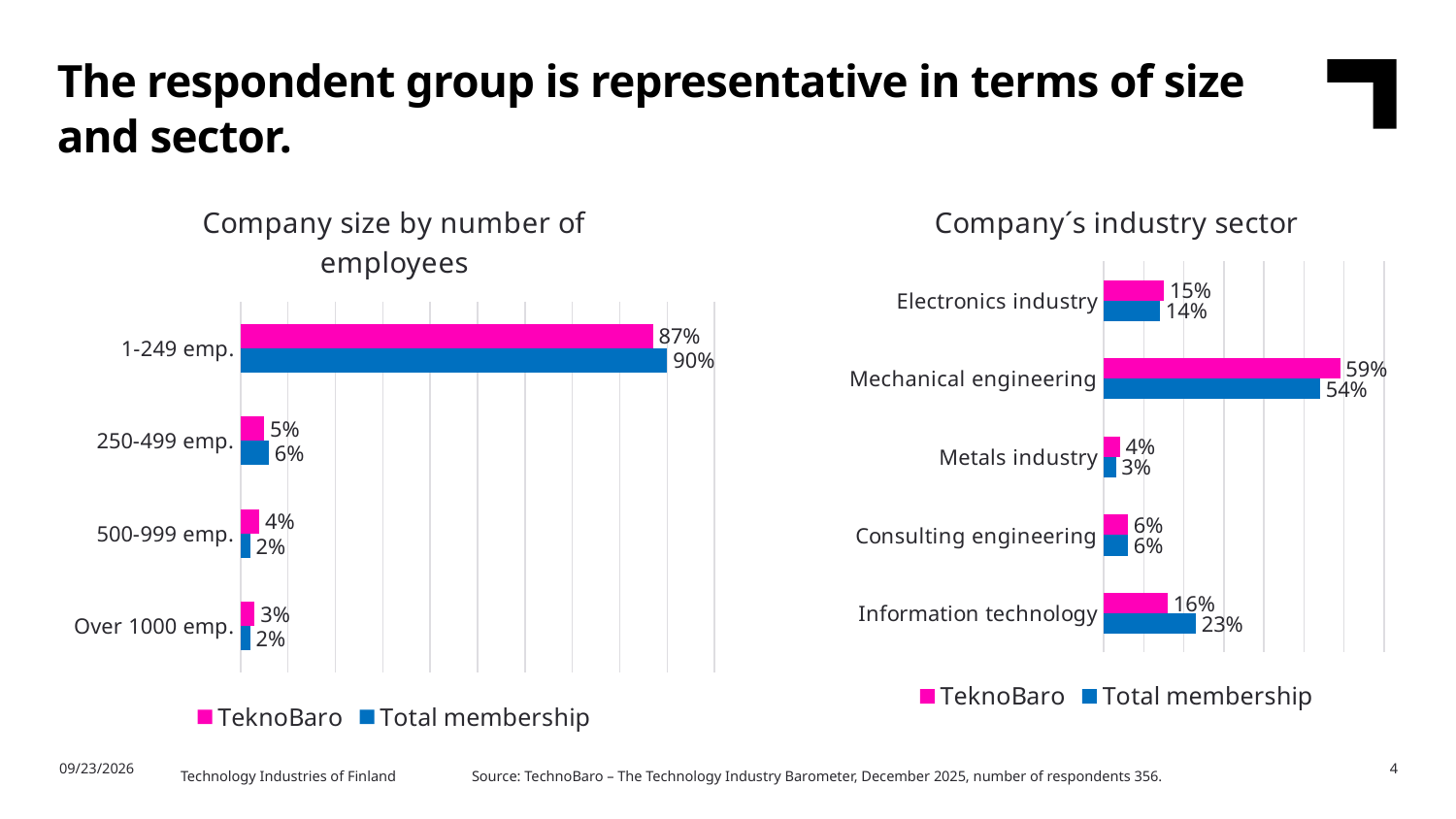
In the 'Company size by number of employees' chart, which category has the highest TeknoBaro value? 1-249 emp. How many series does the legend of the 'Company´s industry sector' chart list? 2 What type of chart is the 'Company size by number of employees' chart? Bar chart In the 'Company size by number of employees' chart, what is the TeknoBaro value for 1-249 emp.? 87% In the 'Company size by number of employees' chart, what is the Total membership value for 250-499 emp.? 6% In the 'Company´s industry sector' chart, what is the TeknoBaro value for Mechanical engineering? 59% In the 'Company´s industry sector' chart, which sector has the lowest Total membership value? Metals industry In the 'Company´s industry sector' chart, what is the difference between the TeknoBaro and Total membership values for Mechanical engineering? 5% In the 'Company´s industry sector' chart, what is the Total membership value for Information technology? 23% In the 'Company´s industry sector' chart, which is larger for Information technology: the TeknoBaro value or the Total membership value? Total membership In the 'Company size by number of employees' chart, what is the difference between the Total membership and TeknoBaro values for 1-249 emp.? 3% In the 'Company size by number of employees' chart, how many company size categories are shown? 4